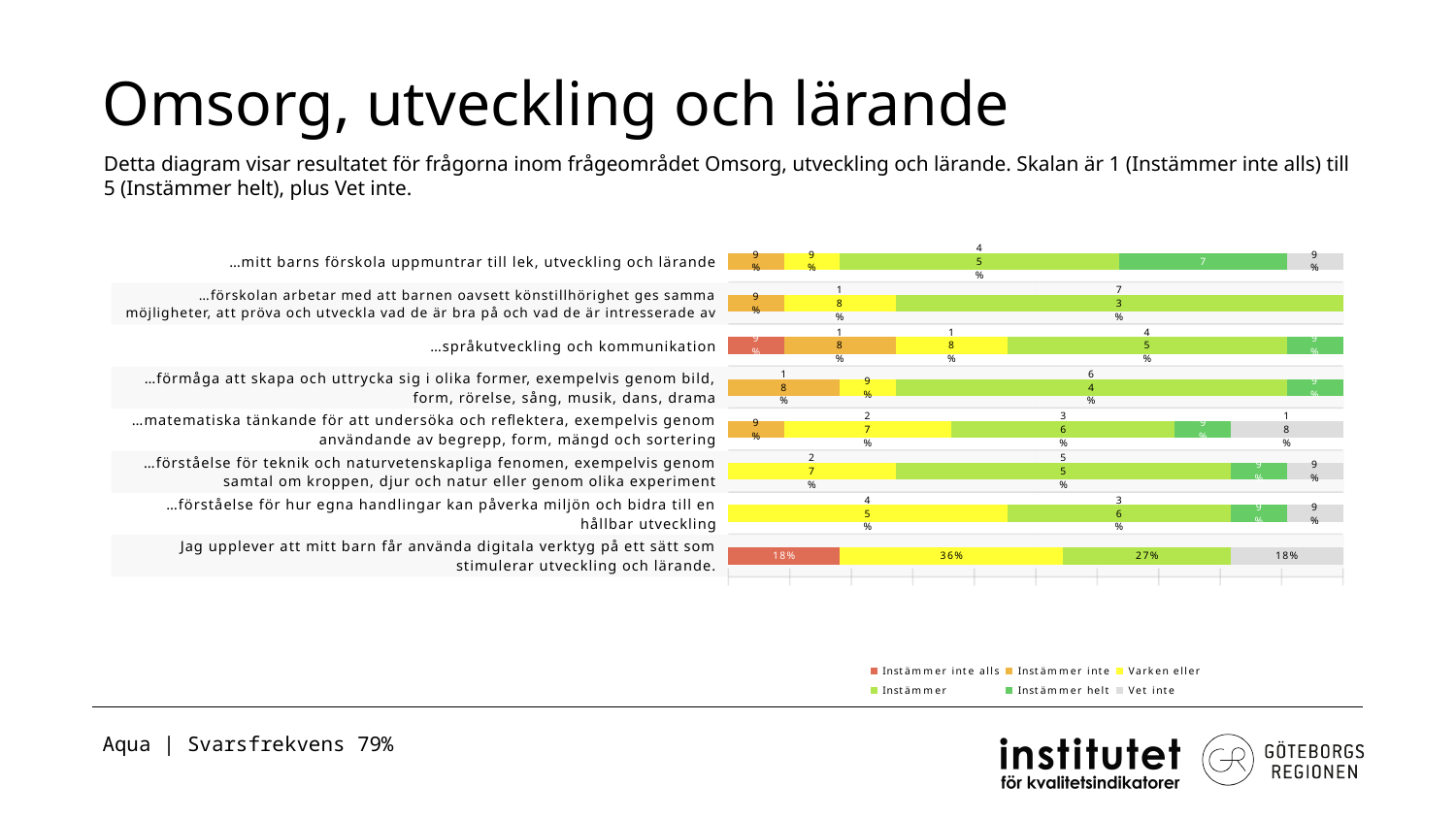
Which statement has the largest 'Instämmer' share? …förskolan arbetar med att barnen oavsett könstillhörighet ges samma möjligheter, att pröva och utveckla vad de är bra på och vad de är intresserade av What is the 'Varken eller' value for 'Jag upplever att mitt barn får använda digitala verktyg på ett sätt som stimulerar utveckling och lärande'? 36% How many series does the legend list? 6 For 'Jag upplever att mitt barn får använda digitala verktyg…', which is larger: the 'Varken eller' share or the 'Instämmer' share? Varken eller What is the 'Instämmer' value for '…förmåga att skapa och uttrycka sig i olika former, exempelvis genom bild, form, rörelse, sång, musik, dans, drama'? 64% For 'Jag upplever att mitt barn får använda digitala verktyg…', what is the difference between the 'Varken eller' share (36%) and the 'Vet inte' share (18%)? 18 percentage points How many question statements (categories) are plotted in the chart? 8 What is the 'Instämmer' value for '…förskolan arbetar med att barnen oavsett könstillhörighet ges samma möjligheter, att pröva och utveckla vad de är bra på och vad de är intresserade av'? 73% What is the 'Instämmer inte alls' value for 'Jag upplever att mitt barn får använda digitala verktyg på ett sätt som stimulerar utveckling och lärande'? 18% What is the 'Instämmer' value for 'Jag upplever att mitt barn får använda digitala verktyg på ett sätt som stimulerar utveckling och lärande'? 27% What kind of chart is shown on the slide? Stacked bar chart What colour represents 'Vet inte' in the legend? Grey